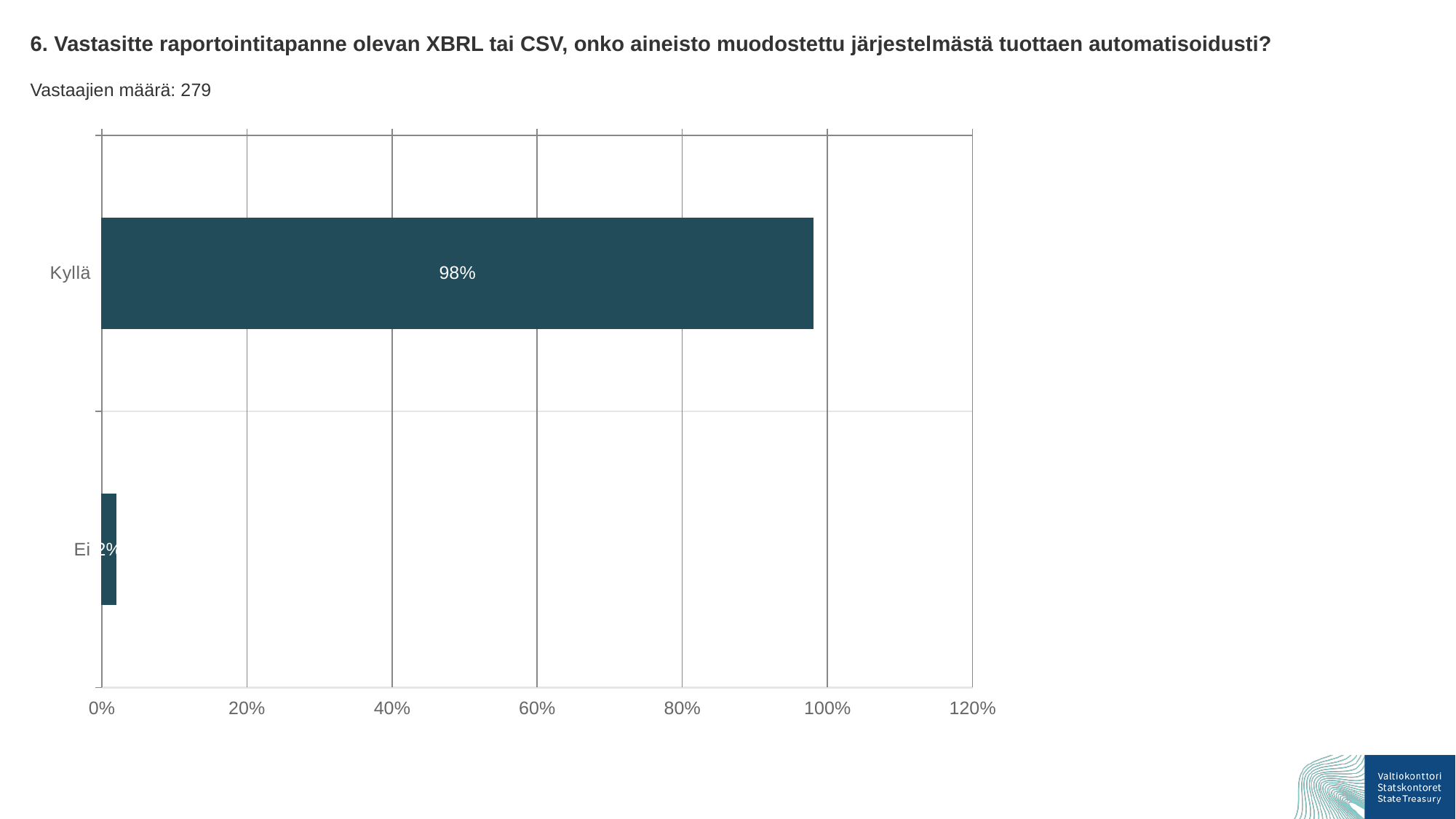
What is the highest value shown on the x axis? 120% What is the number of respondents (Vastaajien määrä) stated on the slide? 279 Which is larger, the value for Kyllä or the value for Ei? Kyllä What is the value for Kyllä? 98% Which category has the lowest value? Ei Is the value for Ei greater or less than 20%? less Is the value for Kyllä greater or less than 80%? greater What is the value for Ei? 2% How many categories are shown in the chart? 2 What is the difference between the values for Kyllä and Ei? 96% What kind of chart is shown on the slide? bar chart Which category has the highest value? Kyllä